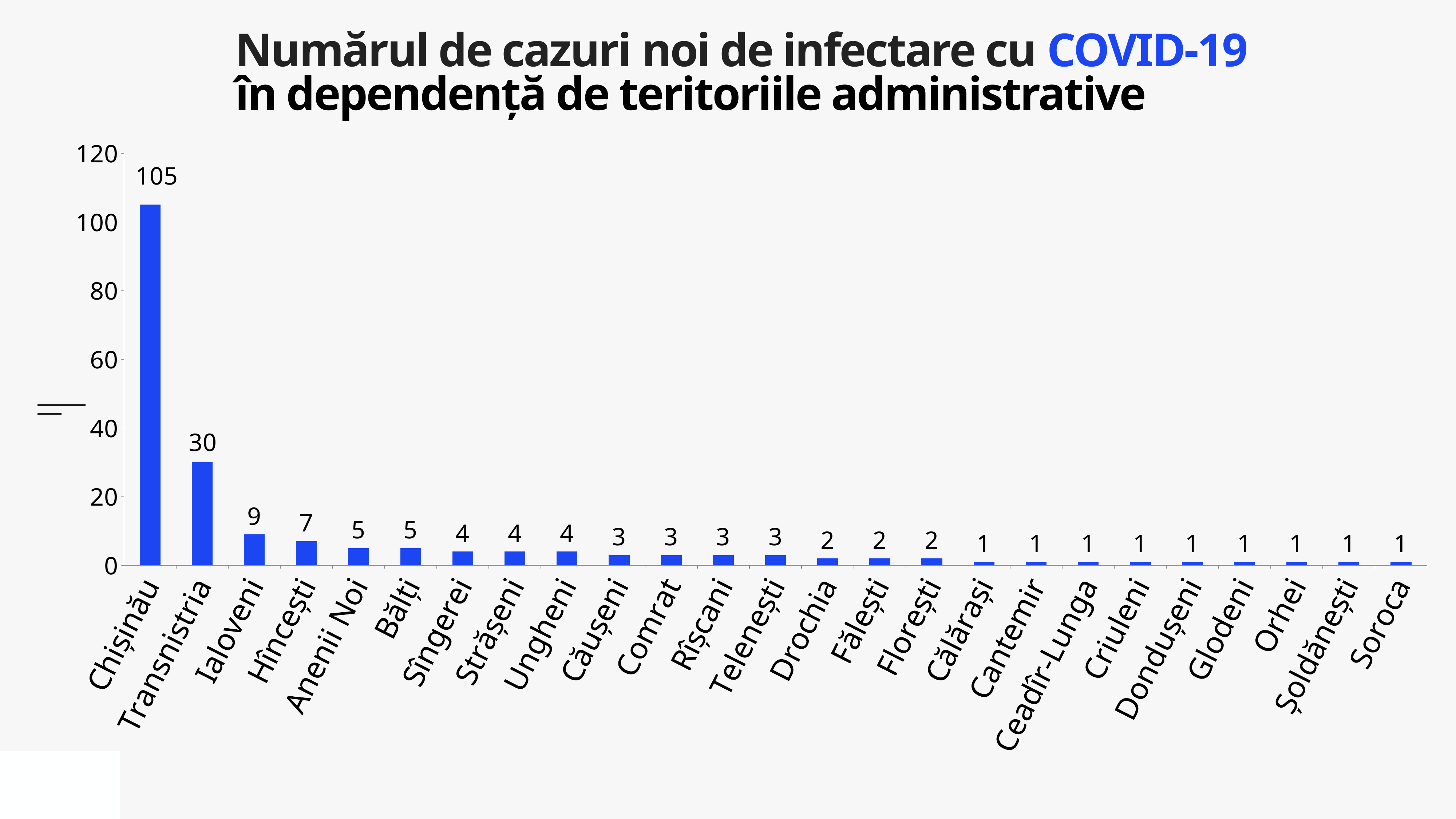
What is the difference between the values for Chișinău and Transnistria? 75 What kind of chart is shown on the slide? bar chart What is the value for Drochia? 2 Is the value for Chișinău greater or less than 100? greater What is the value for Chișinău? 105 Which territory has the highest number of new cases? Chișinău Which is larger, the value for Anenii Noi or the value for Ungheni? Anenii Noi What is the value for Ialoveni? 9 How many territories are shown on the x axis? 25 What is the difference between the values for Ialoveni and Bălți? 4 What is the value for Hîncești? 7 What is the value for Transnistria? 30